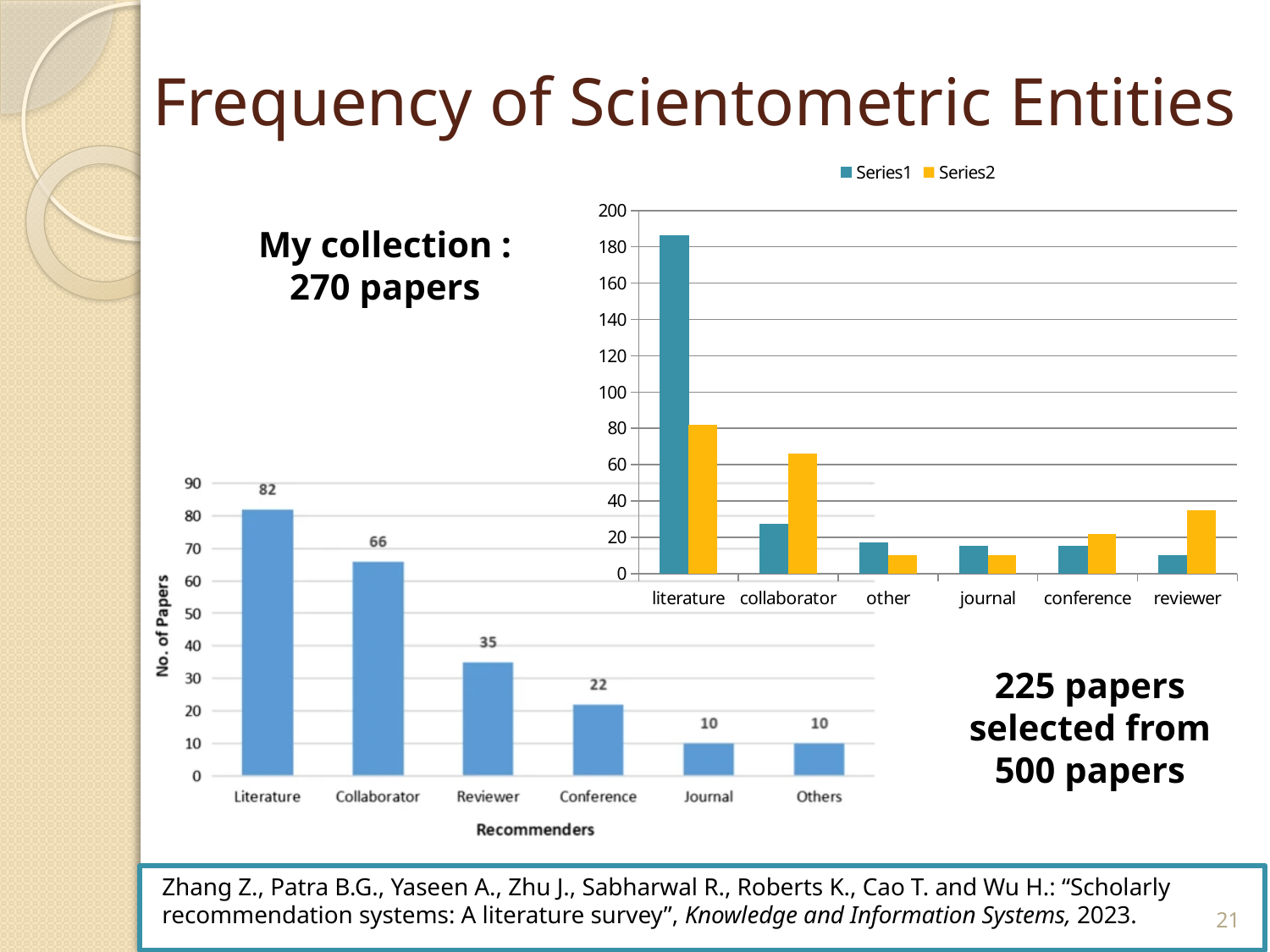
In the bottom-left chart, how many recommender categories are shown on the x axis? 6 In the bottom-left chart, what is the difference between the values for Literature and Collaborator? 16 What kind of chart is the top-right chart? bar chart In the top-right chart, how many series does the legend list? 2 In the bottom-left chart, what is the value for Reviewer? 35 In the top-right chart, is the Series2 value for collaborator greater or less than 40? greater In the bottom-left chart, what is the label of the y axis? No. of Papers In the top-right chart, which category has the highest Series1 value? literature In the bottom-left chart, what is the value for Literature? 82 In the top-right chart, is the Series1 value for literature greater or less than 160? greater In the bottom-left chart, which is larger, the value for Reviewer or the value for Conference? Reviewer In the bottom-left chart, which recommender has the highest number of papers? Literature